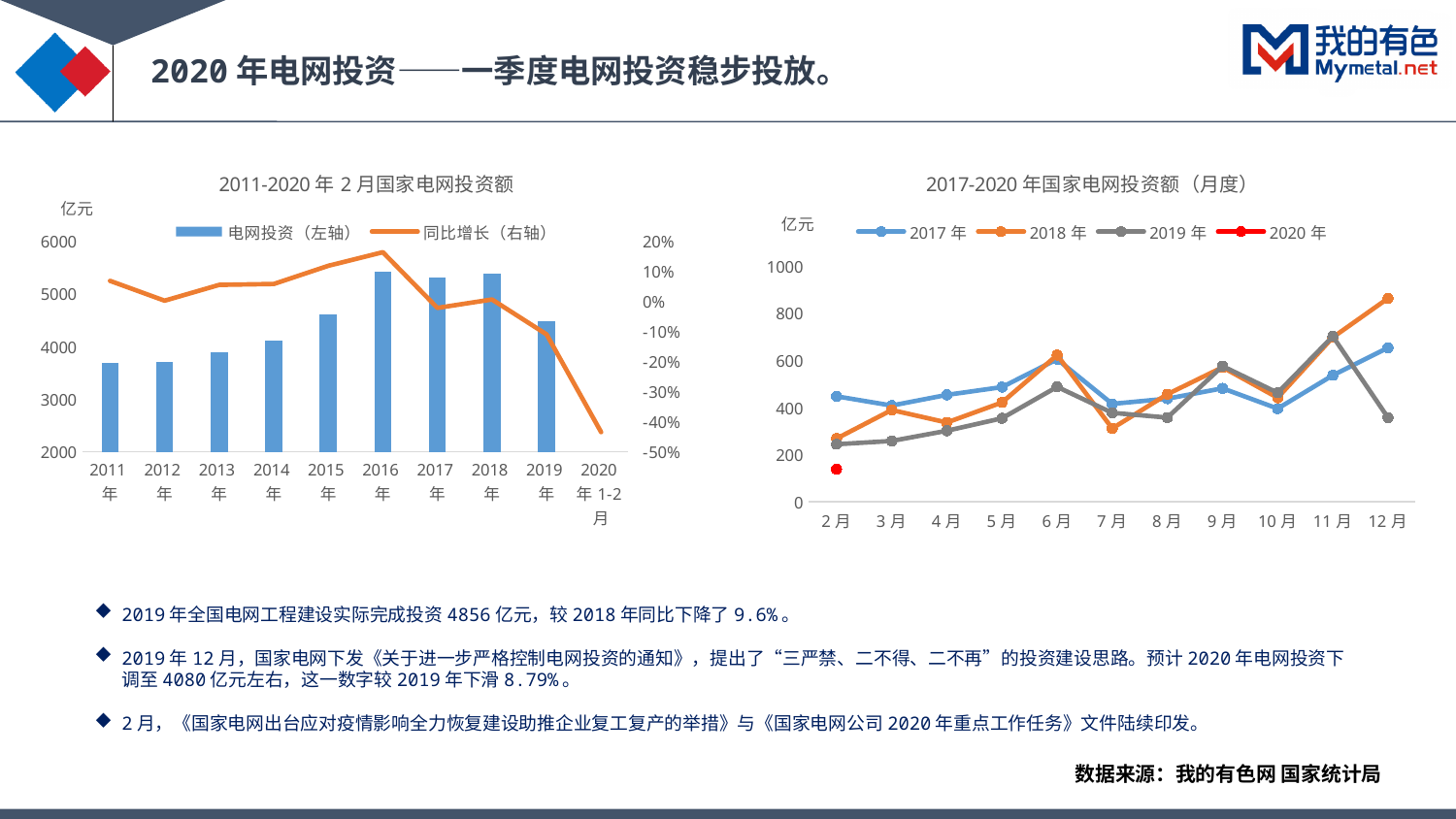
In the left chart (2011-2020年2月国家电网投资额), how many categories are shown on the x axis? 10 In the left chart (2011-2020年2月国家电网投资额), which category has the lowest 同比增长 value? 2020年1-2月 In the left chart (2011-2020年2月国家电网投资额), which category has the highest 同比增长 value? 2016年 In the left chart (2011-2020年2月国家电网投资额), is the 同比增长 value for 2020年1-2月 greater or less than -30%? less In the left chart (2011-2020年2月国家电网投资额), how many series does the legend list? 2 What kind of chart is the right chart (2017-2020年国家电网投资额（月度）)? line chart In the left chart (2011-2020年2月国家电网投资额), is the 电网投资 value for 2011年 greater or less than 4000? less In the right chart (2017-2020年国家电网投资额（月度）), how many months are shown on the x axis? 11 In the right chart (2017-2020年国家电网投资额（月度）), is the 2018年 value for 12月 greater or less than 800? greater In the right chart (2017-2020年国家电网投资额（月度）), how many series does the legend list? 4 In the right chart (2017-2020年国家电网投资额（月度）), which is larger in 12月, the 2018年 value or the 2019年 value? 2018年